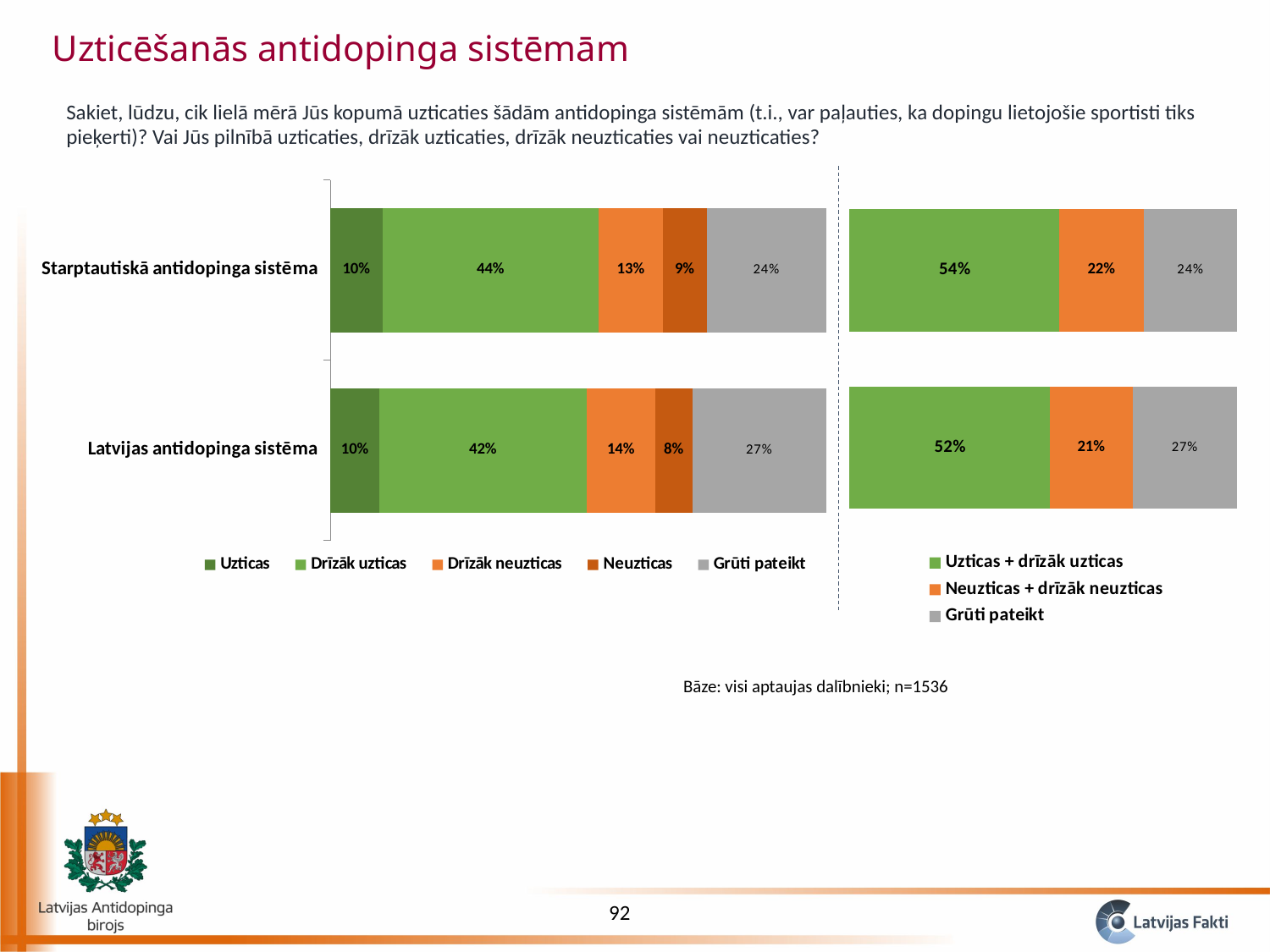
In the left chart, what is the value of "Neuzticas" for Latvijas antidopinga sistēma? 8% How many series does the legend of the right chart list? 3 In the left chart, which system has the higher "Grūti pateikt" value? Latvijas antidopinga sistēma How many categories are shown in the left chart? 2 In the right chart, what is the value of "Grūti pateikt" for Starptautiskā antidopinga sistēma? 24% In the left chart, what is the value of "Drīzāk uzticas" for Starptautiskā antidopinga sistēma? 44% In the right chart, what is the value of "Uzticas + drīzāk uzticas" for Latvijas antidopinga sistēma? 52% In the left chart, what is the difference between the "Drīzāk neuzticas" values for Latvijas antidopinga sistēma and Starptautiskā antidopinga sistēma? 1% In the left chart, which series has the largest segment for Latvijas antidopinga sistēma? Drīzāk uzticas In the right chart, what is the difference between the "Uzticas + drīzāk uzticas" values for Starptautiskā antidopinga sistēma and Latvijas antidopinga sistēma? 2% What kind of chart is the right chart? Stacked bar chart How many series does the legend of the left chart list? 5